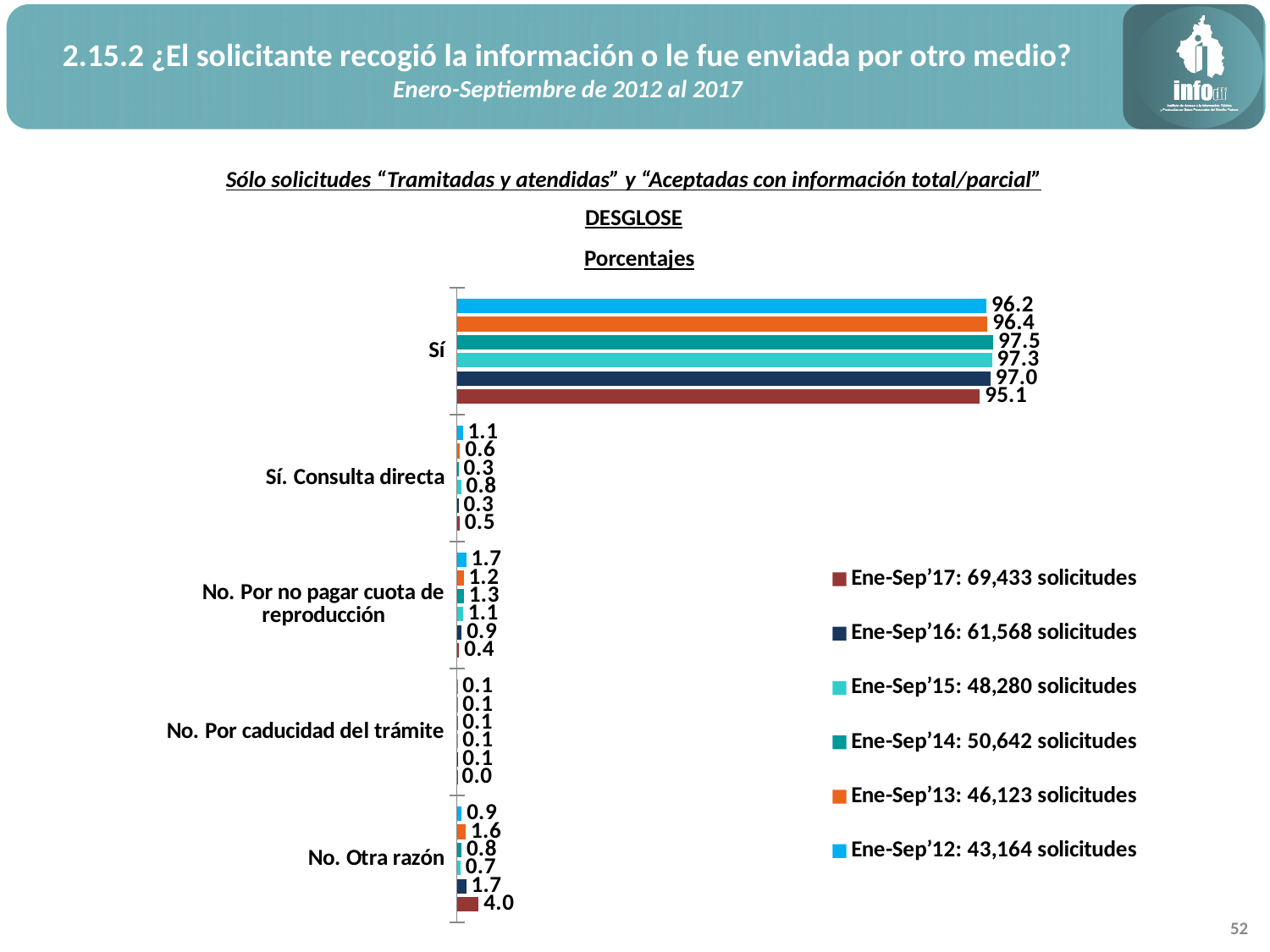
What is the value for "No. Por no pagar cuota de reproducción" in the Ene-Sep'16 series? 0.9 What is the difference between the Ene-Sep'14 and Ene-Sep'17 values for "Sí"? 2.4 How many categories are shown on the chart? 5 Which is larger for "No. Otra razón": the Ene-Sep'13 value or the Ene-Sep'16 value? Ene-Sep'16 According to the legend, how many solicitudes does the Ene-Sep'17 series represent? 69,433 solicitudes What is the value for "Sí" in the Ene-Sep'17 series? 95.1 What is the value for "Sí. Consulta directa" in the Ene-Sep'12 series? 1.1 What is the value for "No. Otra razón" in the Ene-Sep'17 series? 4.0 How many series does the legend list? 6 Which series has the highest value for "Sí"? Ene-Sep'14 What kind of chart is shown on the slide? Bar chart Which series has the lowest value for "No. Otra razón"? Ene-Sep'15